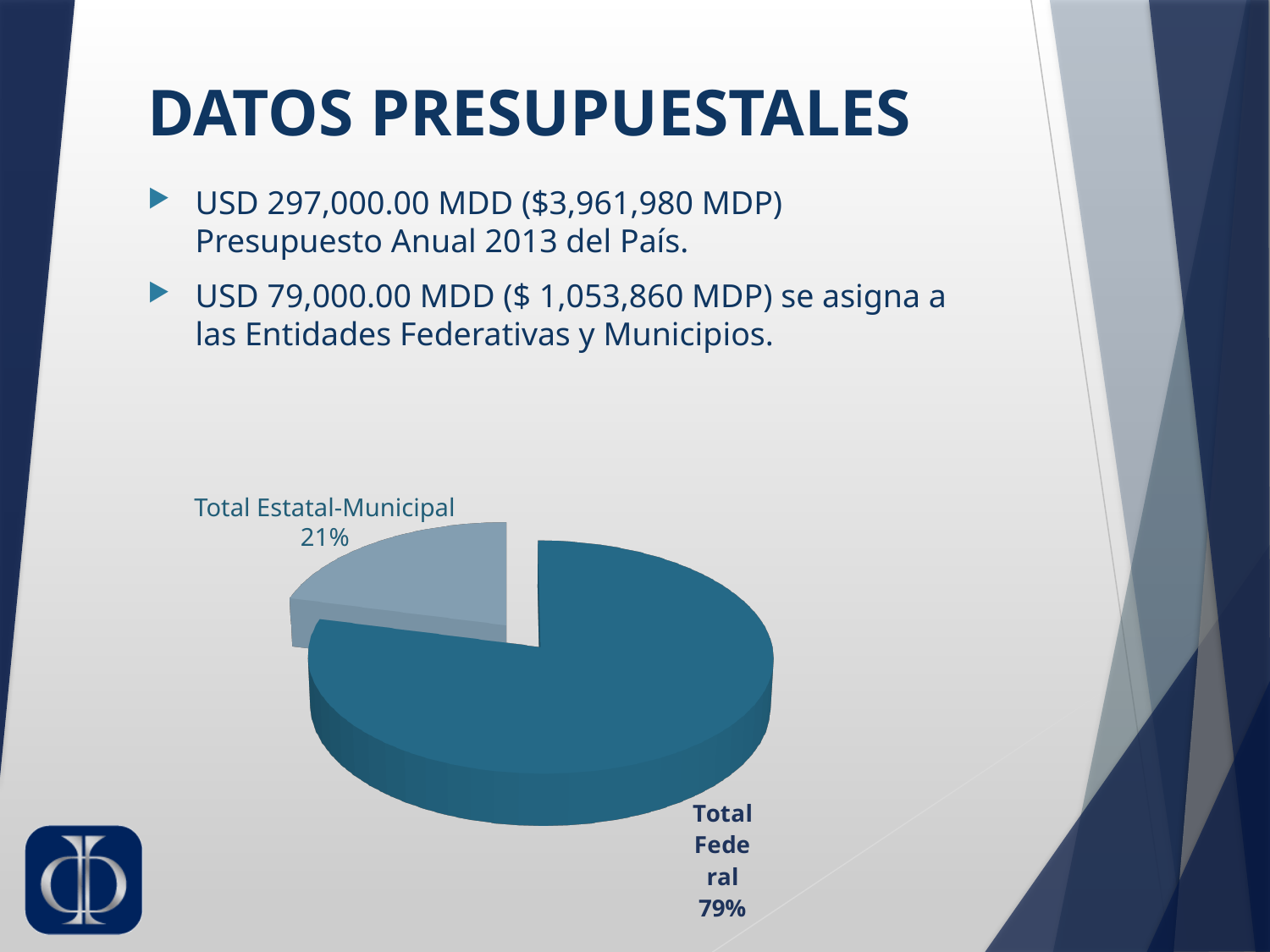
Which slice of the pie is the largest? Total Federal Which slice of the pie is the smallest? Total Estatal-Municipal What is the title of the slide containing the pie chart? DATOS PRESUPUESTALES What share of the pie does Total Estatal-Municipal represent? 21% What is the difference in percentage points between the Total Federal and Total Estatal-Municipal slices? 58 Which slice of the pie is shown in the lighter blue colour? Total Estatal-Municipal What share of the pie does Total Federal represent? 79% What kind of chart is shown on the slide? pie chart Is the share for Total Estatal-Municipal greater or less than 25%? less Is the share for Total Federal greater or less than 75%? greater How many slices does the pie chart have? 2 Which is larger, the Total Federal slice or the Total Estatal-Municipal slice? Total Federal